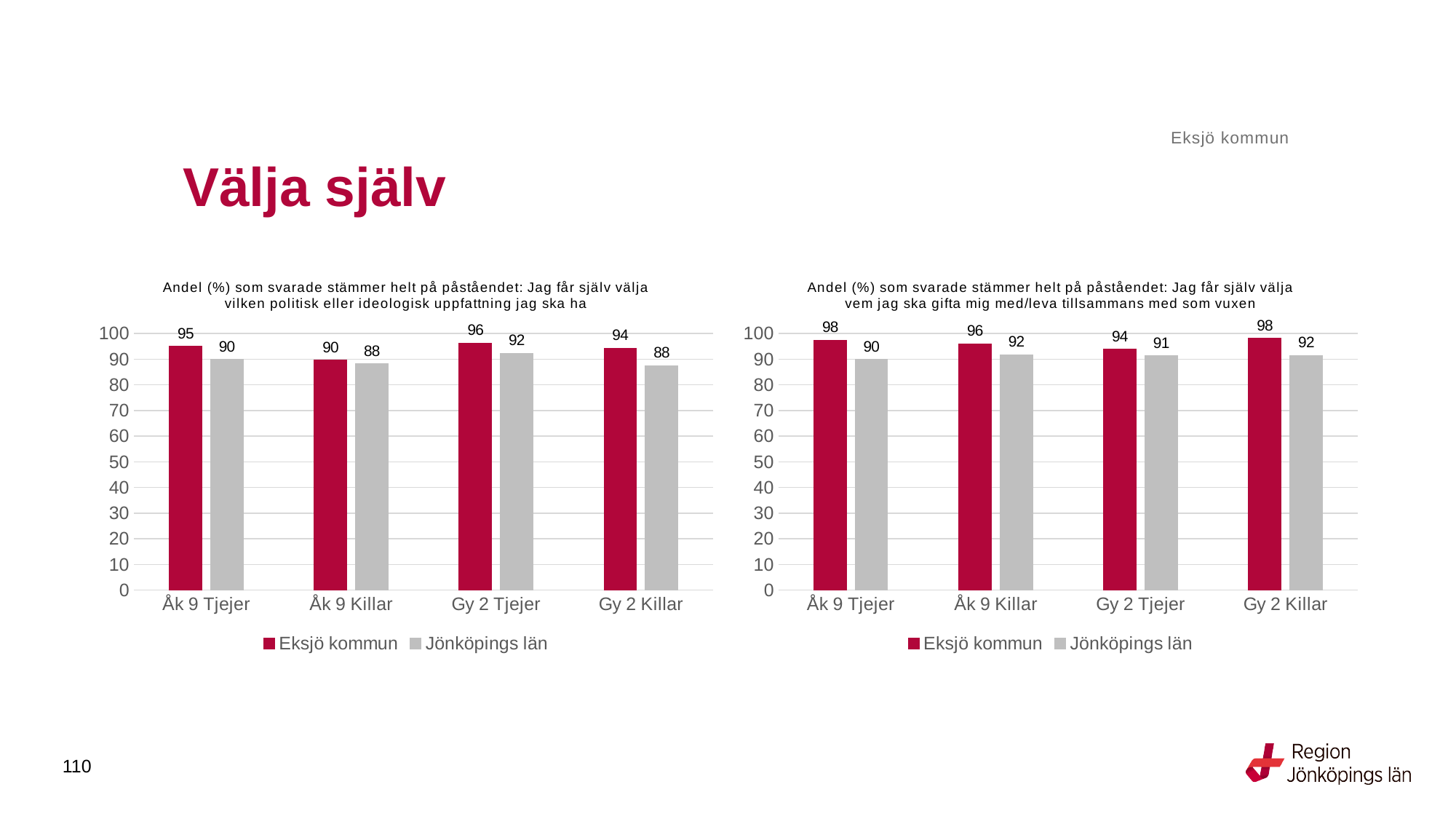
How many series does the legend of the left chart (political or ideological opinion) list? 2 In the left chart (political or ideological opinion), what is the value for Jönköpings län for Gy 2 Killar? 88 In the left chart (political or ideological opinion), what is the value for Eksjö kommun for Åk 9 Tjejer? 95 In the right chart (who to marry/live with), which category has the lowest Eksjö kommun value? Gy 2 Tjejer In the right chart (who to marry/live with), what is the value for Eksjö kommun for Gy 2 Tjejer? 94 What kind of chart is the right chart (who to marry/live with)? Bar chart In the left chart (political or ideological opinion), which is larger for Åk 9 Killar: Eksjö kommun or Jönköpings län? Eksjö kommun In the right chart (who to marry/live with), what is the difference between Eksjö kommun and Jönköpings län for Åk 9 Tjejer? 8 In the left chart (political or ideological opinion), what is the difference between Eksjö kommun and Jönköpings län for Gy 2 Killar? 6 In the right chart (who to marry/live with), what is the value for Jönköpings län for Åk 9 Killar? 92 How many categories are shown on the x axis of the right chart (who to marry/live with)? 4 In the left chart (political or ideological opinion), which category has the highest Eksjö kommun value? Gy 2 Tjejer